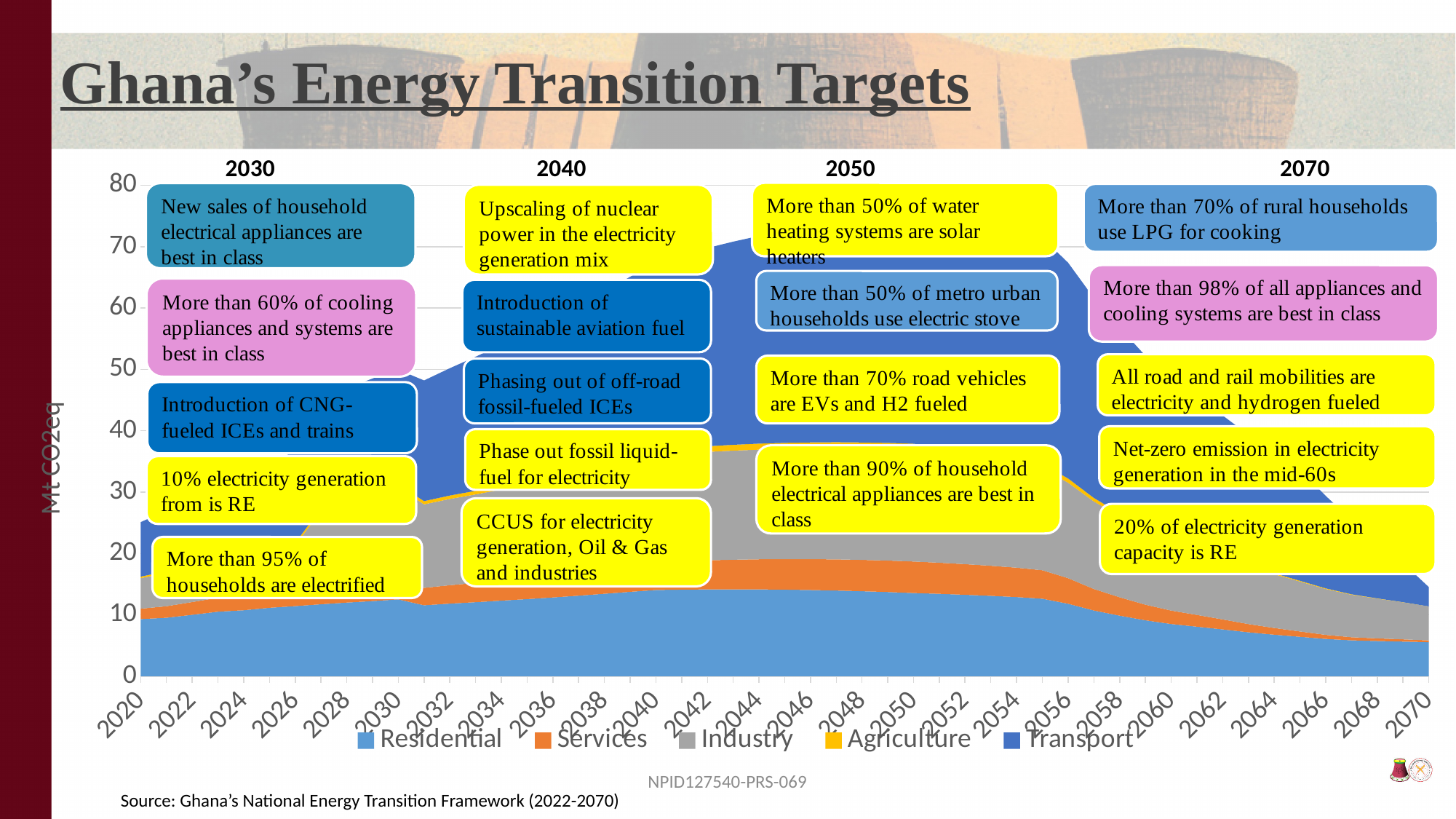
What is the highest value shown on the y axis? 80 How many year labels are shown along the x axis? 26 What is the last year shown on the x axis of the chart? 2070 What is the first year shown on the x axis of the chart? 2020 Is the value for Residential in 2070 greater or less than 10? less How many series does the legend list? 5 Is the total stacked value in 2020 greater or less than 30? less What is the label on the vertical axis of the chart? Mt CO2eq Which series are listed in the chart legend? Residential, Services, Industry, Agriculture, Transport Do total emissions rise or fall between 2056 and 2070? fall What kind of chart is shown on the slide? Stacked area chart Is the total stacked value in 2070 greater or less than 20? less